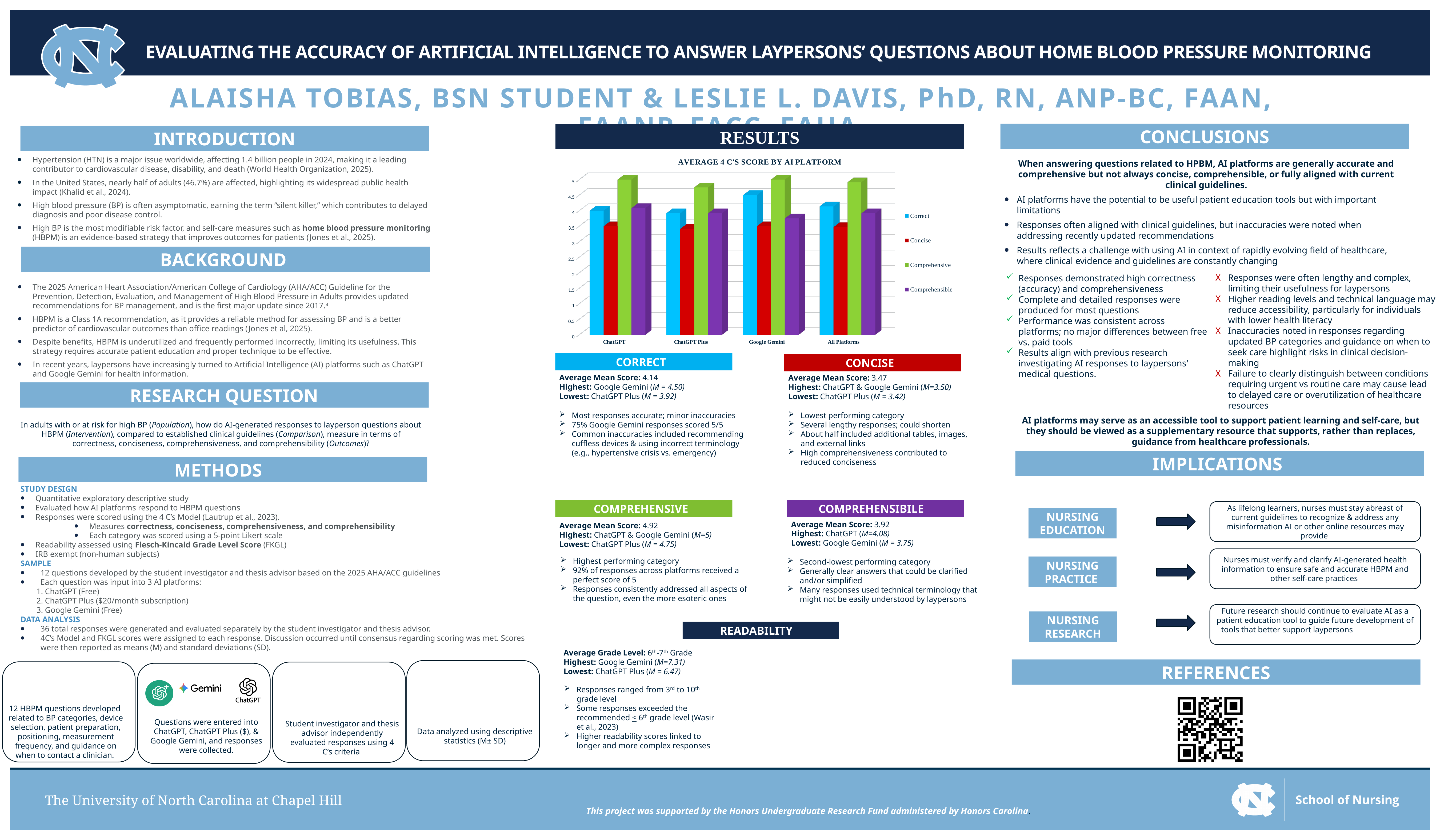
How many AI platform categories are shown on the x axis of the chart? 4 Which series has the lowest bar for ChatGPT Plus in the chart? Concise In the chart, is the Correct bar or the Concise bar larger for Google Gemini? Correct Is the Correct value for Google Gemini greater or less than 4? greater Is the Comprehensive value for ChatGPT Plus greater or less than 4.5? greater What kind of chart is shown under the Results section? bar chart How many series does the chart's legend list? 4 What is the title of the chart in the Results section? AVERAGE 4 C'S SCORE BY AI PLATFORM Is the Comprehensible value for Google Gemini greater or less than 4? less Which colour represents the Comprehensive series in the chart? green Which series has the highest bar for ChatGPT in the chart? Comprehensive